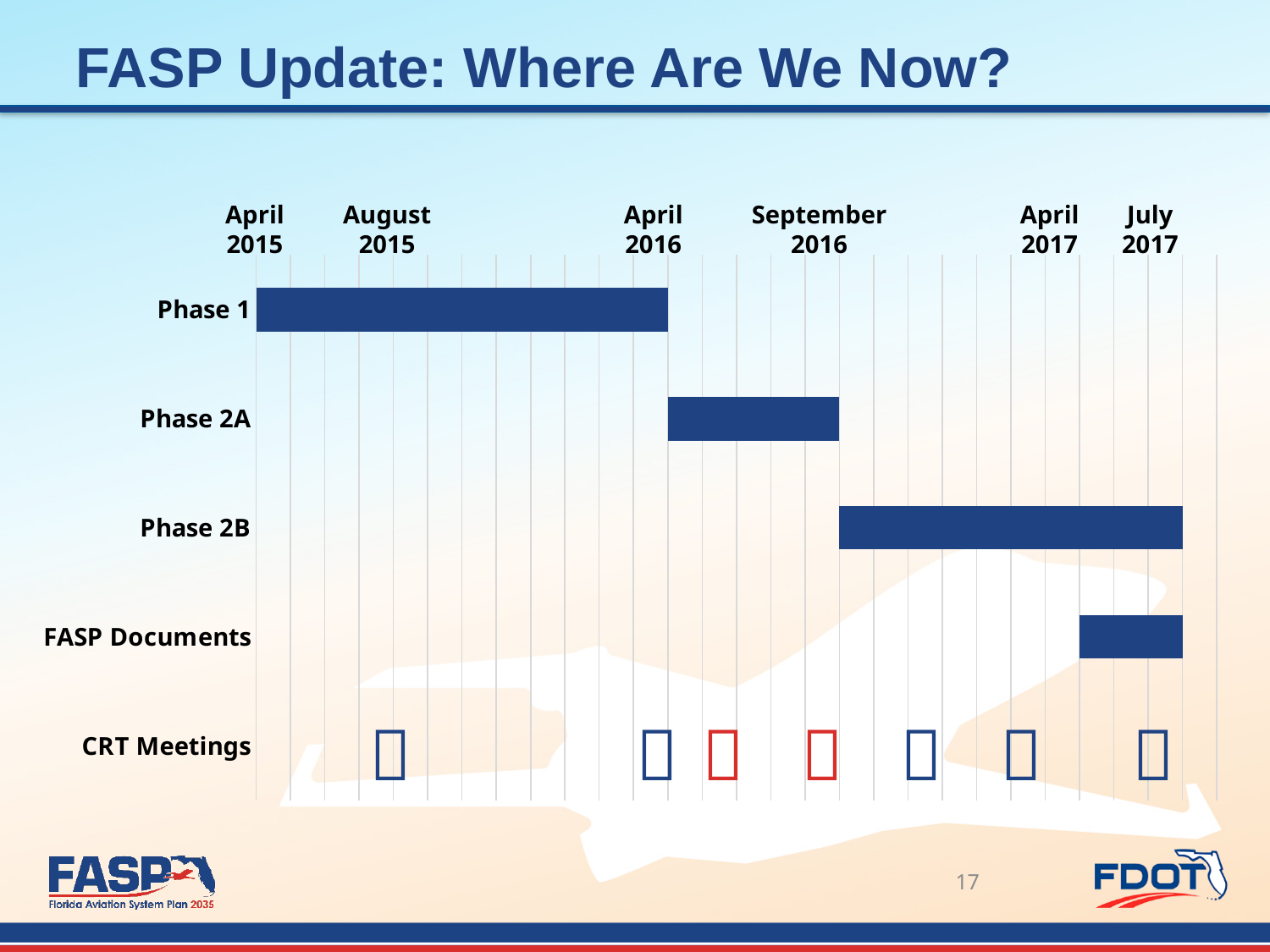
How many of the CRT Meetings markers are outlined in red? 2 What kind of chart is shown on the slide? Gantt chart Which starts earlier on the timeline, Phase 2A or Phase 2B? Phase 2A In which month and year does the Phase 2A bar begin? April 2016 In which month and year does the FASP Documents bar begin? April 2017 In which month and year does the Phase 2B bar begin? September 2016 Which activity has the shortest bar on the timeline? FASP Documents What is the title of the slide containing the timeline chart? FASP Update: Where Are We Now? How many CRT Meetings markers are shown on the timeline? 7 How many rows (activities) are listed on the left of the timeline chart? 5 Which activity has the longest bar on the timeline? Phase 1 In which month and year does the Phase 1 bar end? April 2016